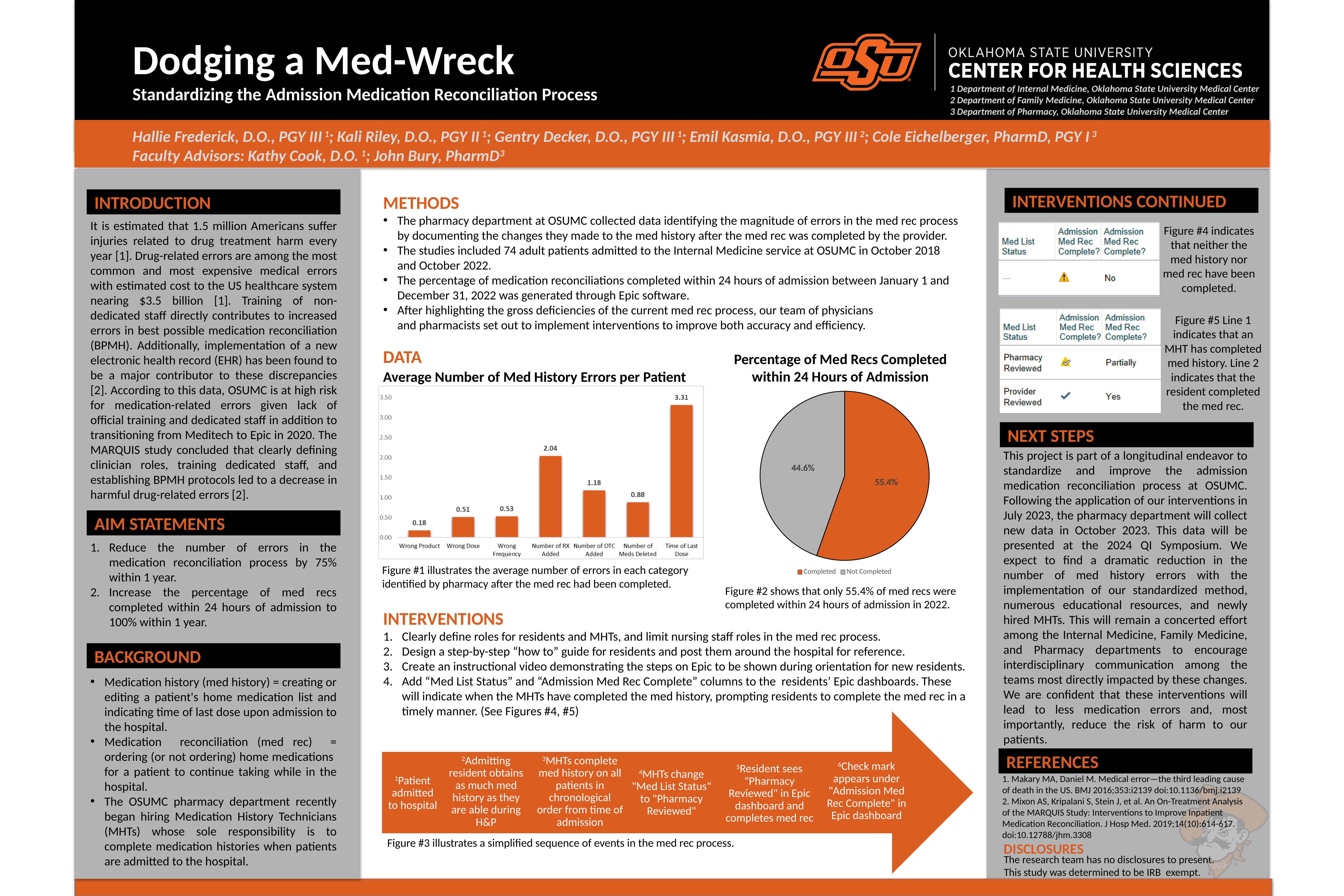
In the 'Average Number of Med History Errors per Patient' chart, which category has the highest value? Time of Last Dose What kind of chart is 'Percentage of Med Recs Completed within 24 Hours of Admission'? pie chart In the 'Percentage of Med Recs Completed within 24 Hours of Admission' chart, what share of the pie is Completed? 55.4% How many categories are shown in the 'Average Number of Med History Errors per Patient' chart? 7 In the 'Average Number of Med History Errors per Patient' chart, which is larger: Number of OTC Added or Number of Meds Deleted? Number of OTC Added In the 'Average Number of Med History Errors per Patient' chart, what is the value for Time of Last Dose? 3.31 In the 'Average Number of Med History Errors per Patient' chart, what is the value for Number of RX Added? 2.04 In the 'Average Number of Med History Errors per Patient' chart, which category has the lowest value? Wrong Product What kind of chart is 'Average Number of Med History Errors per Patient'? bar chart In the 'Percentage of Med Recs Completed within 24 Hours of Admission' chart, what is the value for Not Completed? 44.6% In the 'Average Number of Med History Errors per Patient' chart, is the value for Time of Last Dose greater or less than 3.00? greater In the 'Average Number of Med History Errors per Patient' chart, what is the difference between Number of RX Added and Number of OTC Added? 0.86